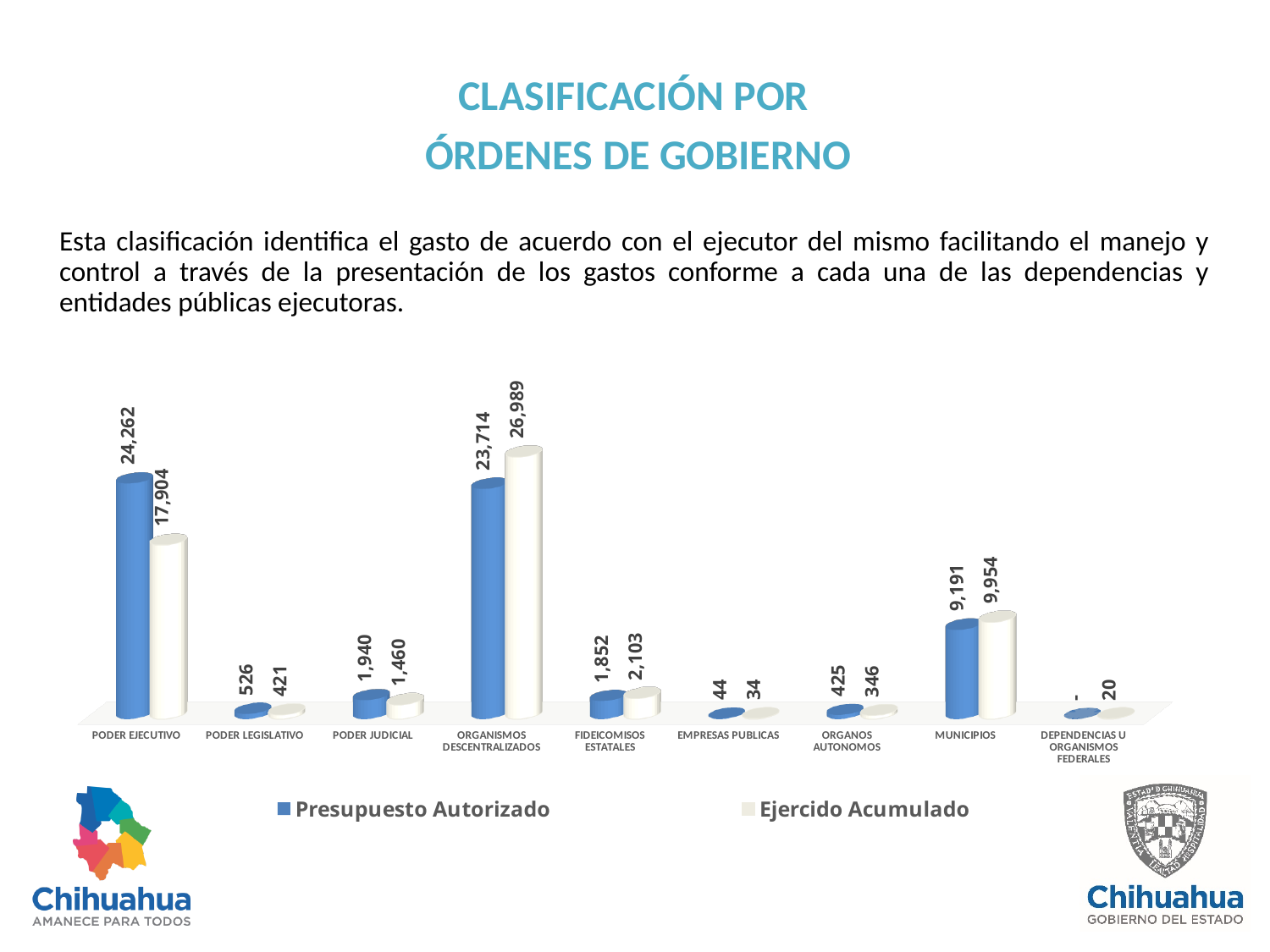
How many series does the chart legend list? 2 What is the Ejercido Acumulado value for Municipios? 9,954 Which series is shown in blue in the chart legend? Presupuesto Autorizado Which category has the highest Ejercido Acumulado value? Organismos Descentralizados What is the Ejercido Acumulado value for Organismos Descentralizados? 26,989 How many categories are shown on the x axis of the chart? 9 What is the difference between Presupuesto Autorizado and Ejercido Acumulado for Poder Ejecutivo? 6,358 What is the Presupuesto Autorizado value for Poder Ejecutivo? 24,262 What is the Presupuesto Autorizado value for Empresas Publicas? 44 For Fideicomisos Estatales, which is larger: Presupuesto Autorizado or Ejercido Acumulado? Ejercido Acumulado Which category has the lowest Presupuesto Autorizado value among those with a numeric label? Empresas Publicas What kind of chart is shown on the slide? Bar chart